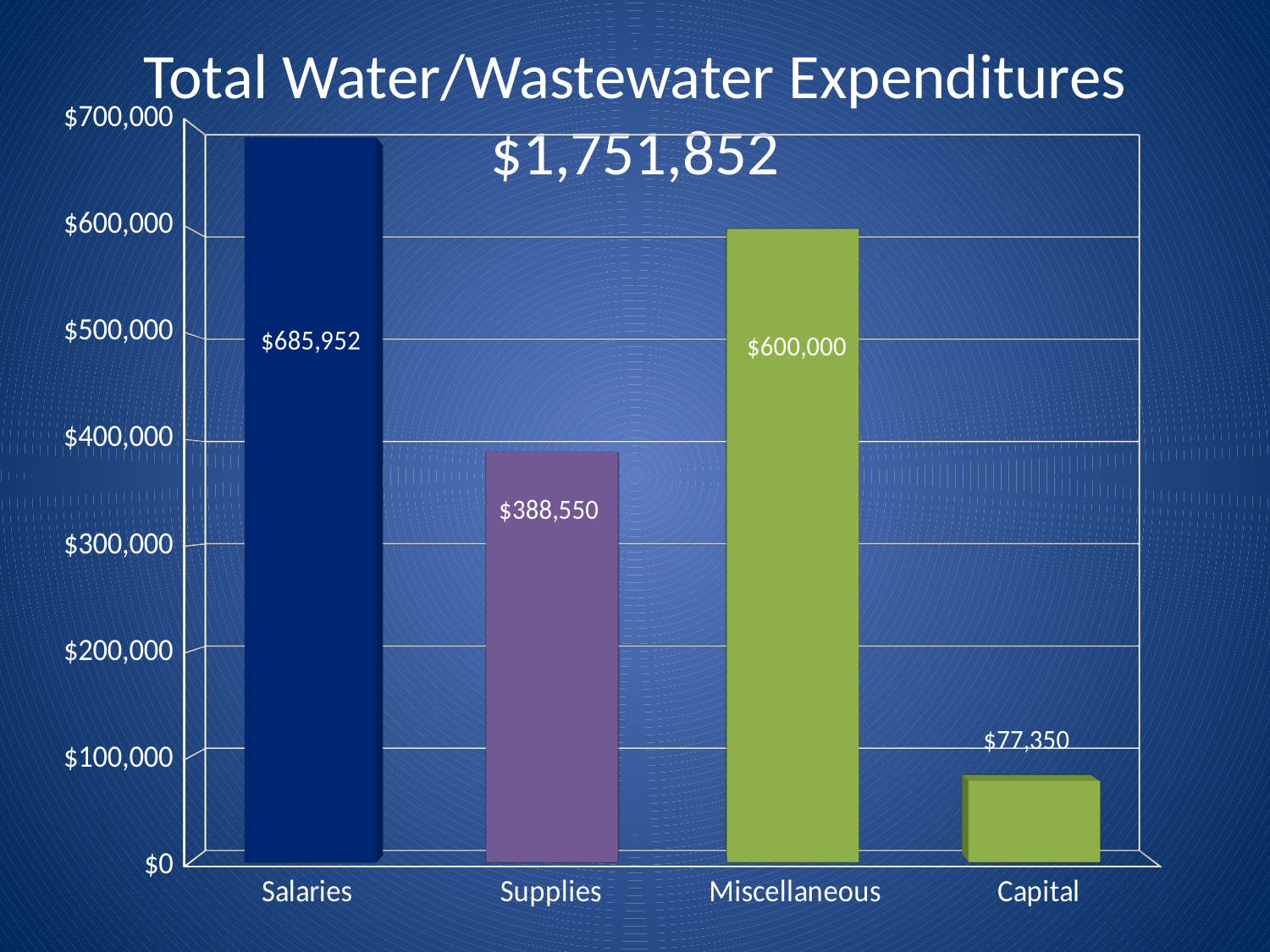
What is the value for Supplies? $388,550 What is the value for Capital? $77,350 What kind of chart is shown on the slide? bar chart What total amount is printed on the chart? $1,751,852 What is the difference between the Salaries and Miscellaneous values? $85,952 What is the value for Salaries? $685,952 Which category has the lowest expenditure? Capital How many categories are shown on the chart? 4 Which is larger, Supplies or Miscellaneous? Miscellaneous What is the value for Miscellaneous? $600,000 Is the value for Supplies greater or less than $400,000? less Which category has the highest expenditure? Salaries